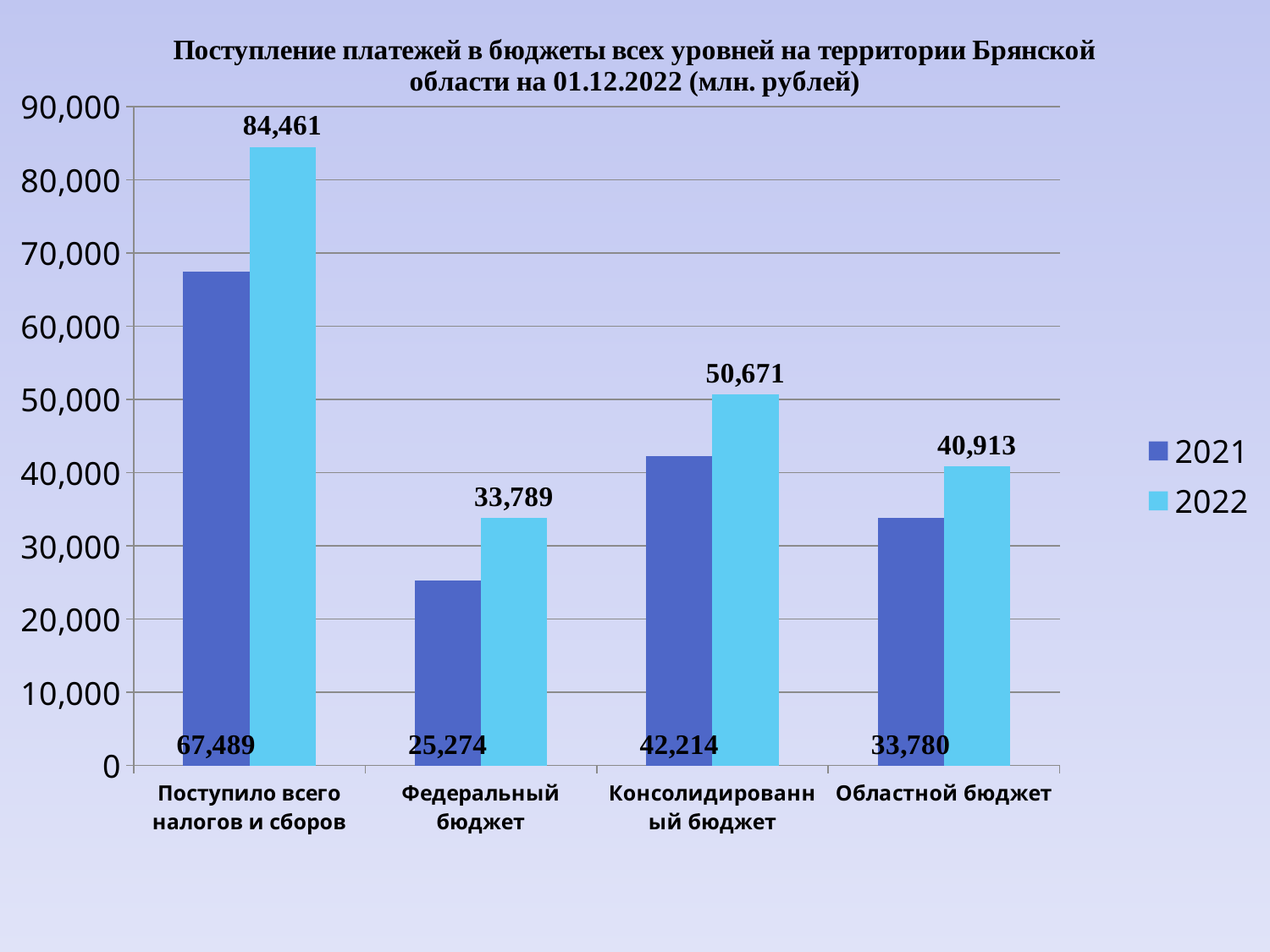
How many categories are shown on the x axis? 4 What is the 2021 value for Федеральный бюджет? 25,274 What is the 2022 value for Поступило всего налогов и сборов? 84,461 What kind of chart is shown on the slide? Bar chart What is the difference between the 2022 and 2021 values for Поступило всего налогов и сборов? 16,972 Which category has the highest 2022 value? Поступило всего налогов и сборов Which is larger: the 2021 value for Консолидированный бюджет or the 2022 value for Федеральный бюджет? 2021 value for Консолидированный бюджет What is the 2022 value for Консолидированный бюджет? 50,671 What is the 2021 value for Областной бюджет? 33,780 What is the difference between the 2022 and 2021 values for Областной бюджет? 7,133 How many series does the legend list? 2 Which category has the lowest 2021 value? Федеральный бюджет